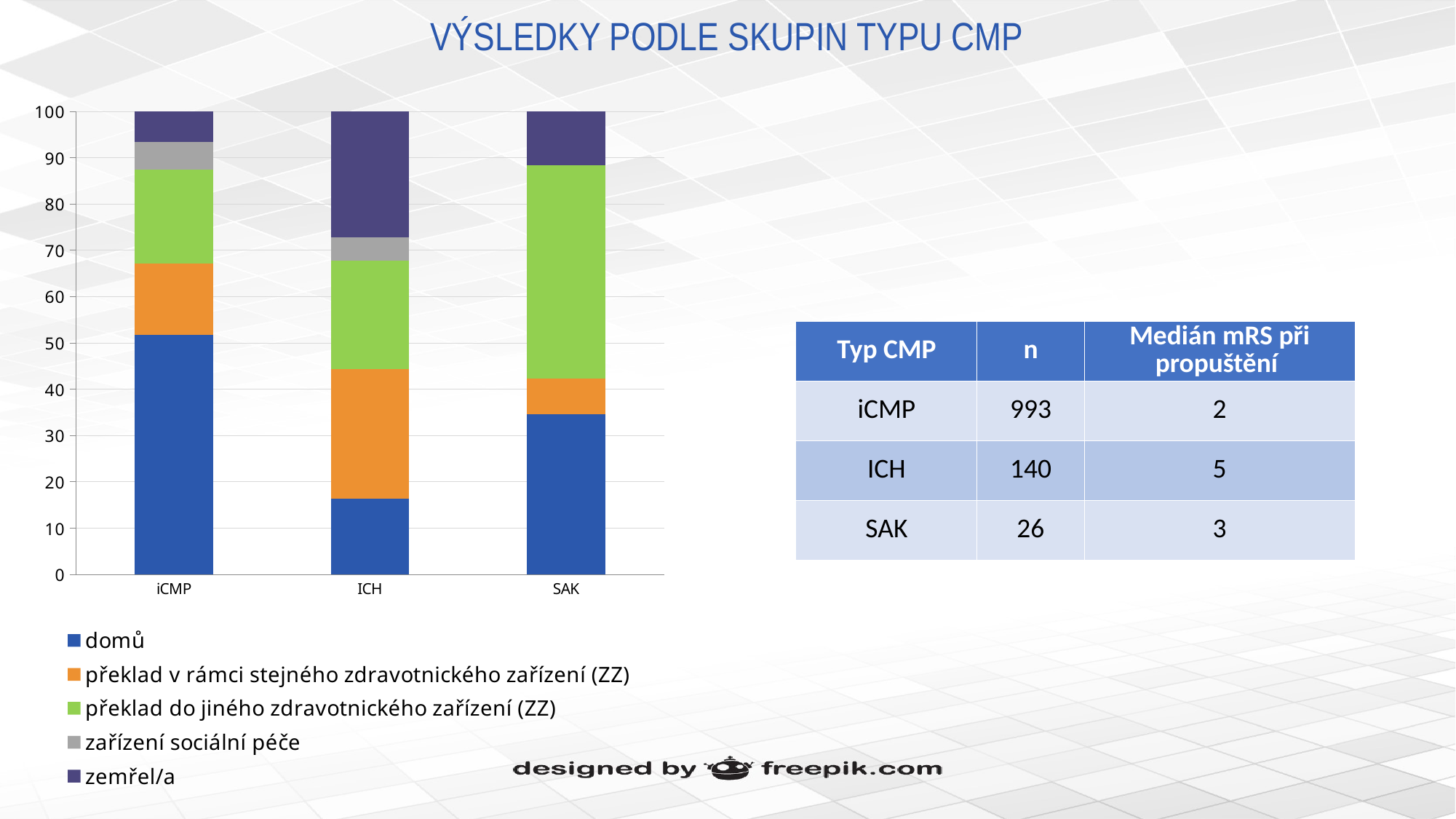
What kind of chart is shown on the slide? stacked bar chart How many series does the chart legend list? 5 Which category has the highest share of 'domů'? iCMP Is the value for 'domů' in the ICH bar greater or less than 20? less Is the value for 'domů' in the iCMP bar greater or less than 40? greater Which is larger: the 'domů' share for iCMP or for ICH? iCMP How many categories are shown on the x axis of the chart? 3 Which category has the lowest share of 'domů'? ICH Which category has the largest 'zemřel/a' segment? ICH What colour represents 'domů' in the chart legend? blue What is the total height of the stacked bar for ICH? 100 Is the value for 'domů' in the SAK bar greater or less than 30? greater